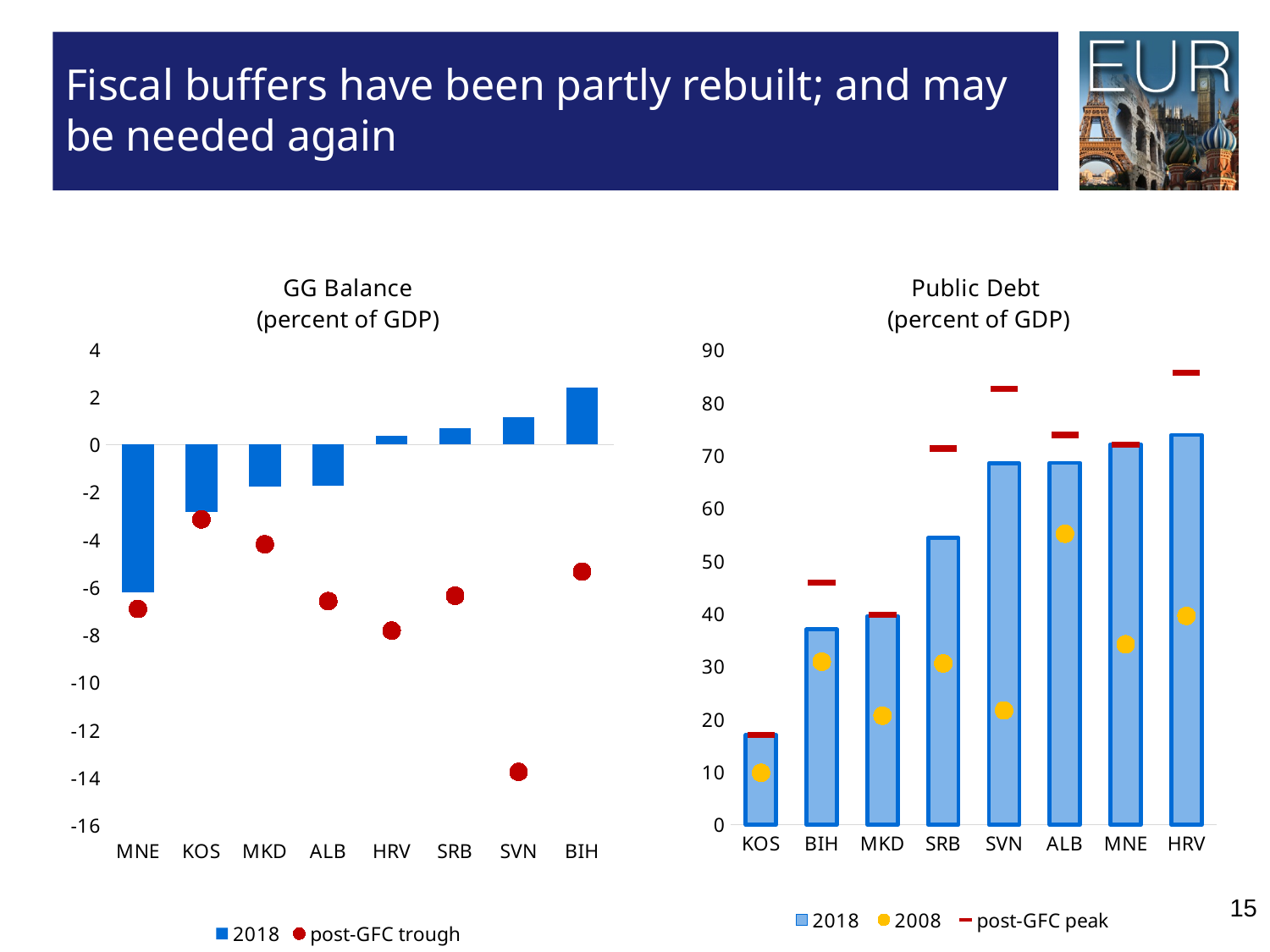
In the Public Debt chart, is the 2018 value for SRB greater or less than 50? greater In the GG Balance chart, which country has the lowest 2018 bar? MNE How many series does the legend of the Public Debt chart list? 3 What kind of chart is the GG Balance chart? bar chart In the GG Balance chart, which country has the highest 2018 bar? BIH In the GG Balance chart, which country has the lowest post-GFC trough marker? SVN In the GG Balance chart, is the 2018 value for MNE greater or less than -4? less In the Public Debt chart, which country has the highest 2008 marker? ALB How many series does the legend of the GG Balance chart list? 2 In the Public Debt chart, do the 2018 bars rise or fall from KOS to HRV along the x axis? rise How many countries are shown on the x axis of the GG Balance chart? 8 In the Public Debt chart, which country has the lowest 2018 bar? KOS